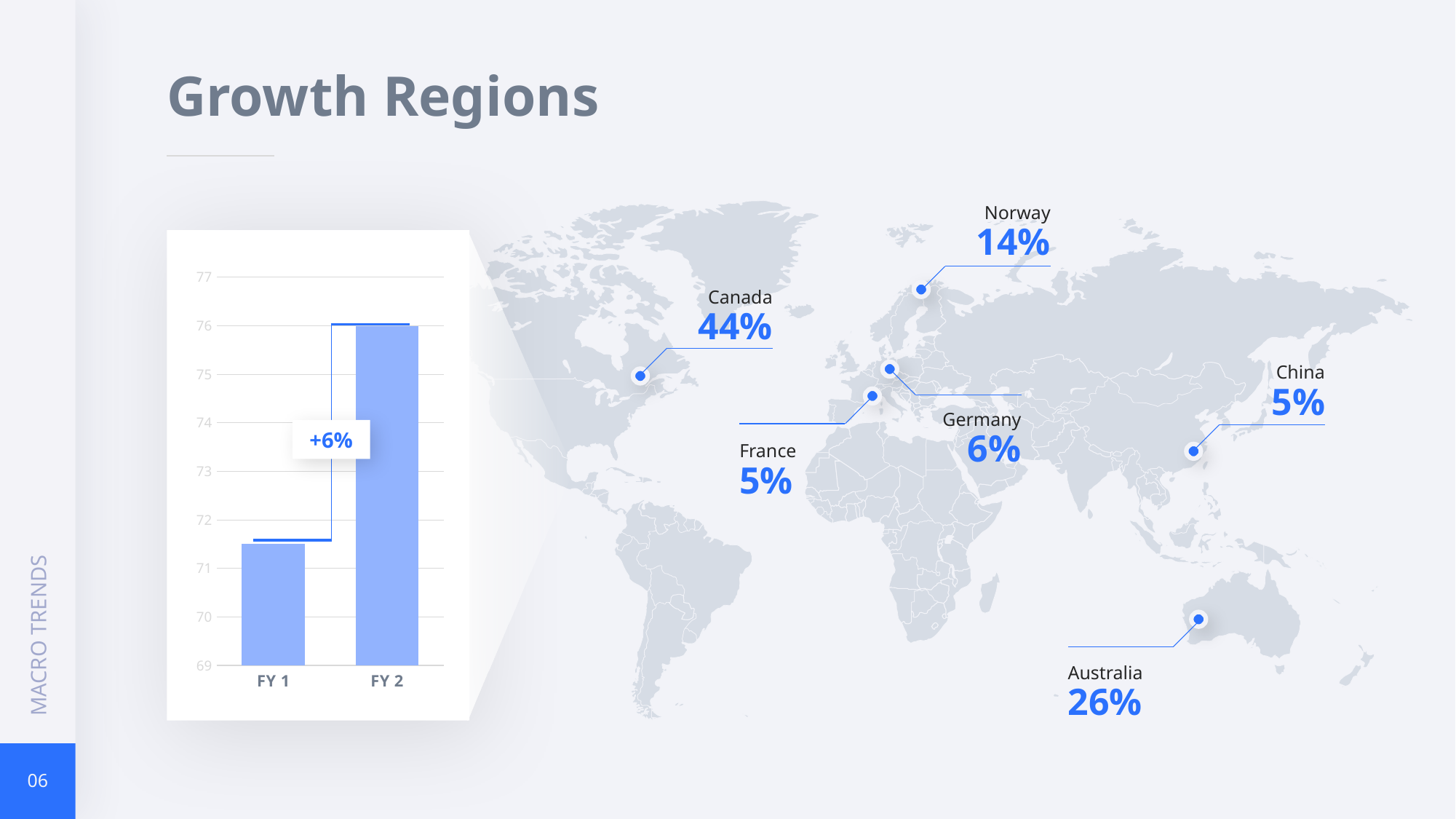
In the bar chart on the left, is the value for FY 1 greater or less than 72? less In the bar chart on the left, which category has the lowest value? FY 1 In the bar chart on the left, which is larger, FY 1 or FY 2? FY 2 In the bar chart on the left, which category has the highest value? FY 2 On the world map, which region has the highest growth percentage? Canada How many categories does the bar chart on the left show? 2 What kind of chart is shown on the left of the slide? bar chart What percentage change is annotated between the two bars in the bar chart on the left? +6% What is the lowest value shown on the y axis of the bar chart on the left? 69 In the bar chart on the left, what is the value for FY 2? 76 In the bar chart on the left, do the values rise or fall from FY 1 to FY 2? rise In the bar chart on the left, is the value for FY 1 greater or less than 71? greater